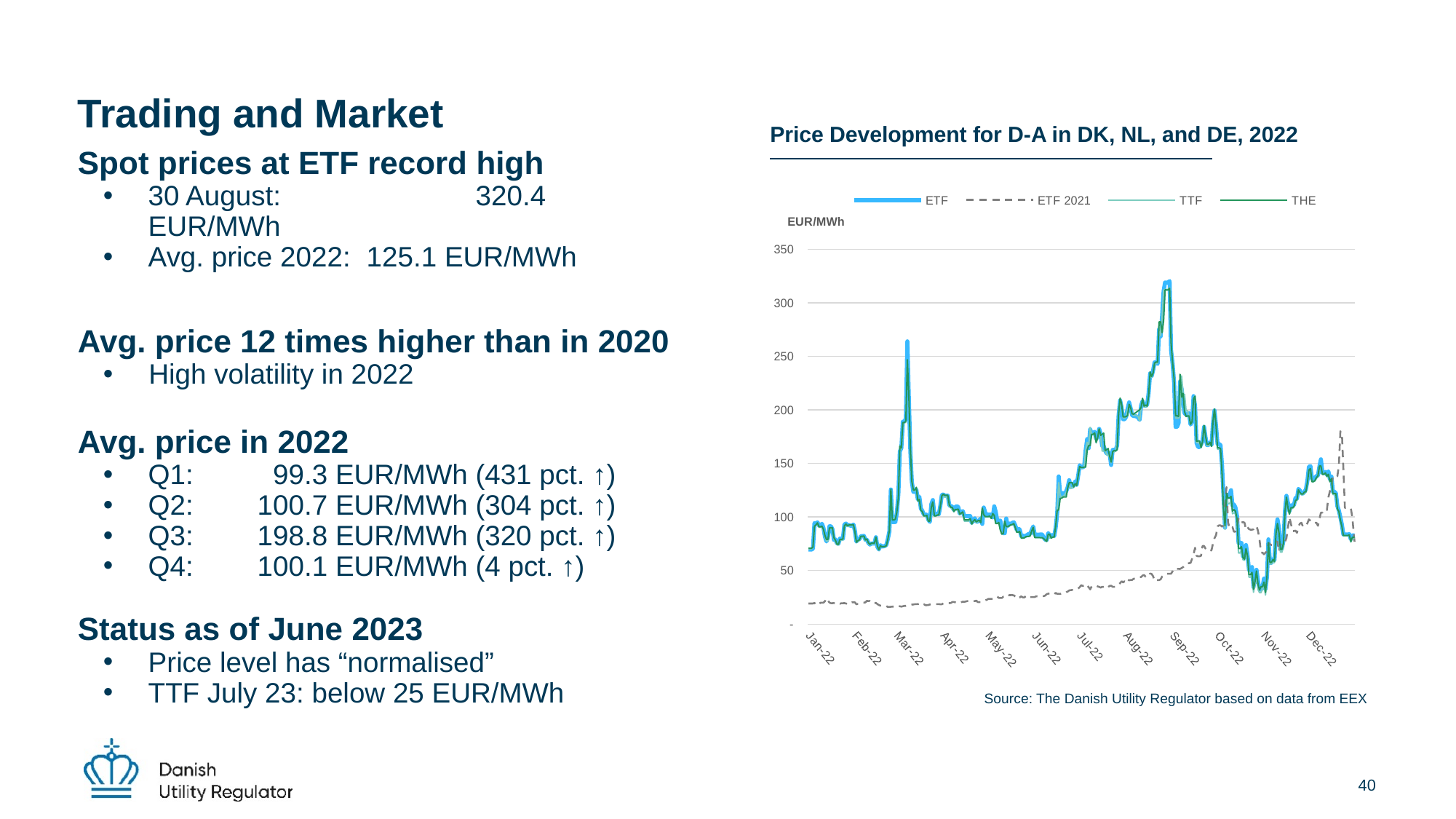
Is the value of the ETF 2021 series in Jan-22 greater or less than 50? less Is the lowest value of the ETF series in Nov-22 greater or less than 50? less In Jan-22, which series has the larger value, ETF or ETF 2021? ETF What kind of chart is shown on the slide? line chart Is the peak value of the ETF 2021 series in Dec-22 greater or less than 150? greater How many month labels are shown on the x axis of the chart? 12 Which series has the lowest values for most of the year in the chart? ETF 2021 What are the series listed in the chart's legend? ETF, ETF 2021, TTF, THE How many series does the legend of the chart list? 4 What unit is shown on the y axis of the chart? EUR/MWh